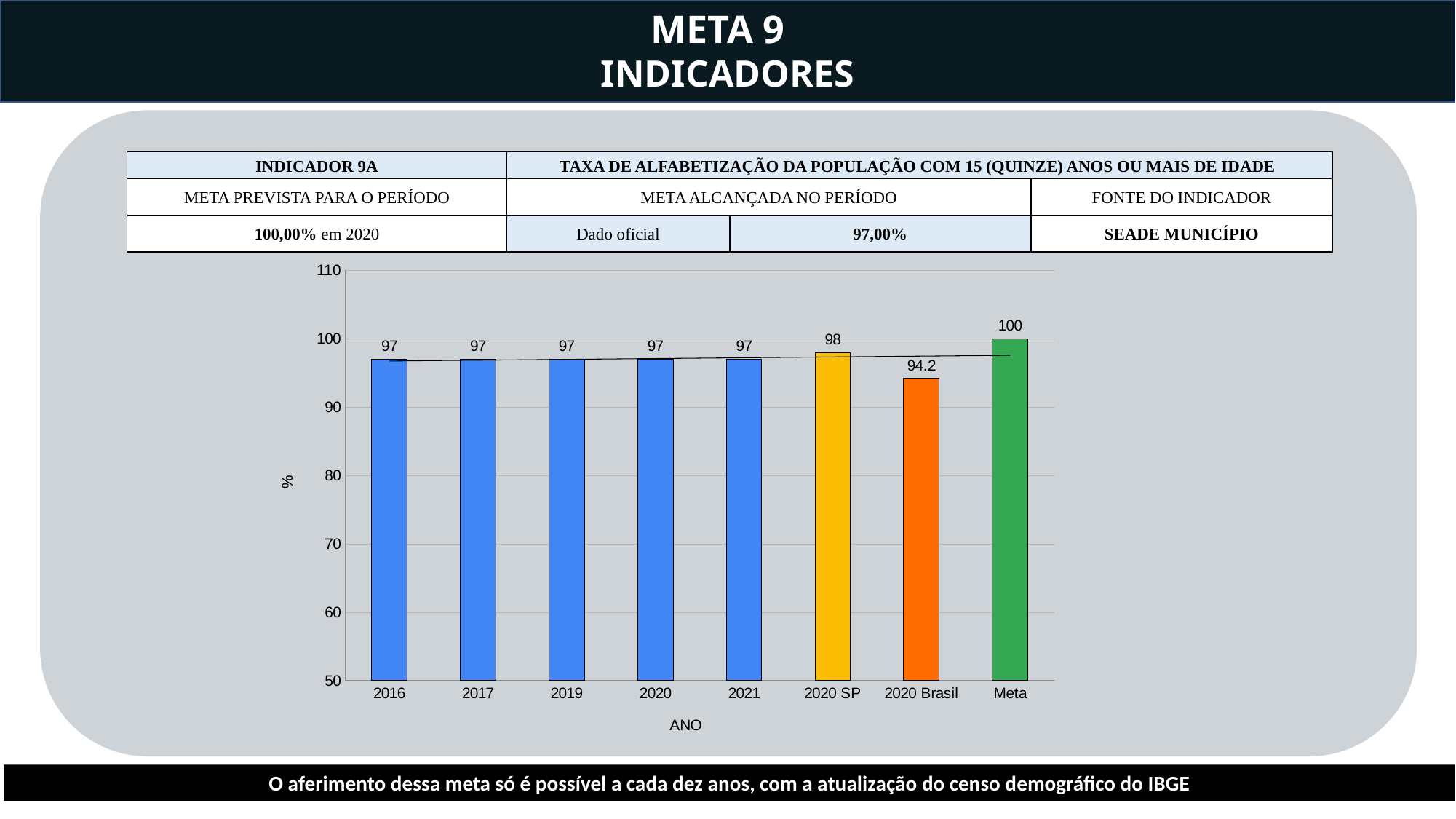
Which is larger, the value for 2020 SP or the value for 2021? 2020 SP What is the value for 2016? 97 What is the value for 2020 SP? 98 What is the difference between the Meta value and the 2020 Brasil value? 5.8 Which category has the highest value? Meta What is the value for 2020 Brasil? 94.2 Which category has the lowest value? 2020 Brasil How many bars are shown in the chart? 8 What kind of chart is shown on the slide? bar chart What is the label of the x axis? ANO What is the value for Meta? 100 Is the value for 2020 Brasil greater or less than 90? greater